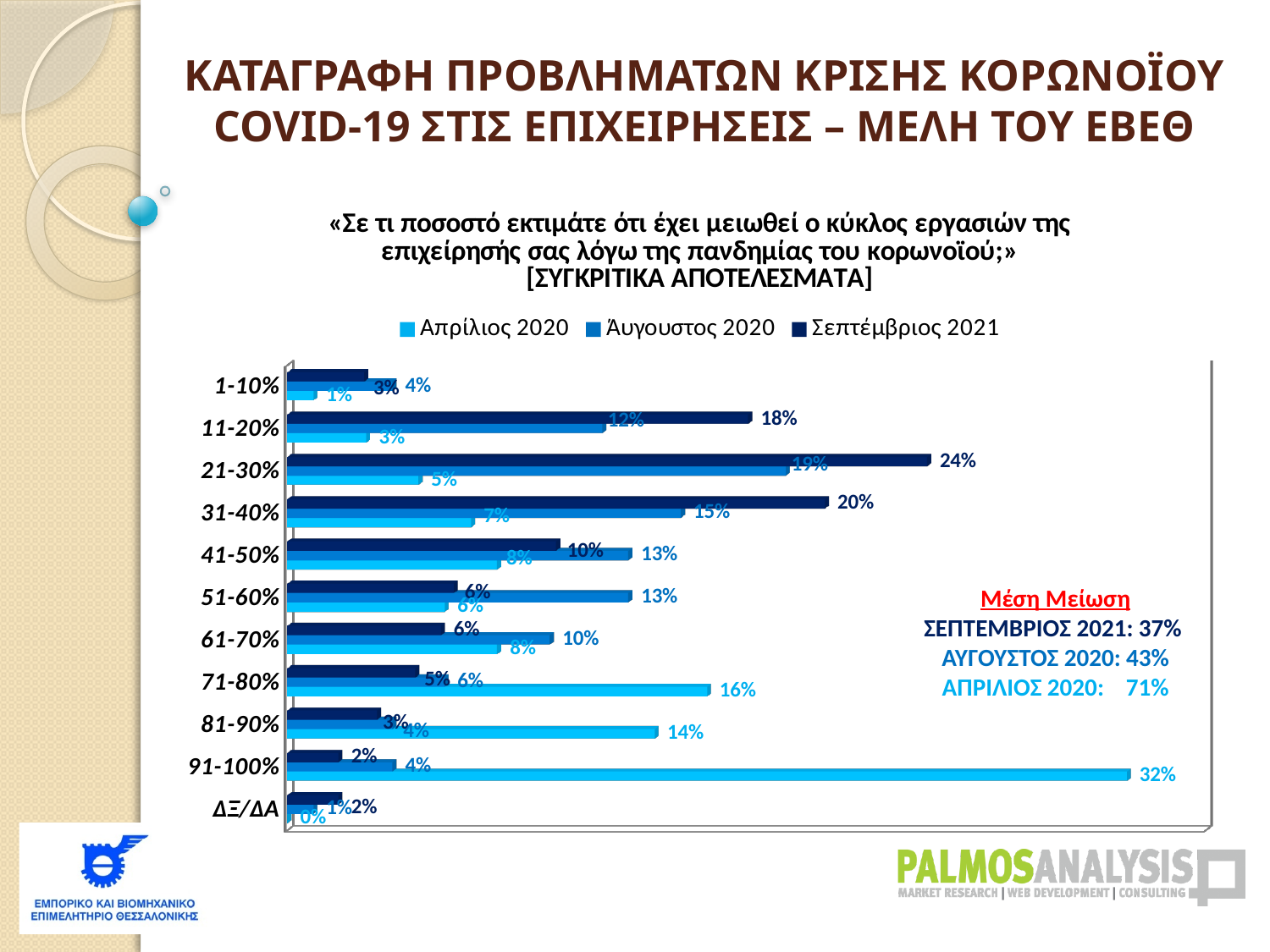
What is the value for Σεπτέμβριος 2021 in the 21-30% category? 24% What kind of chart is shown on the slide? bar chart What is the value for Σεπτέμβριος 2021 in the 11-20% category? 18% What is the value for Απρίλιος 2020 in the 91-100% category? 32% Which category has the highest value for Απρίλιος 2020? 91-100% What is the difference between the Σεπτέμβριος 2021 values for 21-30% and 11-20%? 6 percentage points What is the value for Σεπτέμβριος 2021 in the 31-40% category? 20% How many series does the legend list? 3 How many categories are shown on the vertical axis of the chart? 11 In the 91-100% category, which series has the larger value, Απρίλιος 2020 or Σεπτέμβριος 2021? Απρίλιος 2020 Which category has the highest value for Σεπτέμβριος 2021? 21-30% What is the value for Απρίλιος 2020 in the 71-80% category? 16%